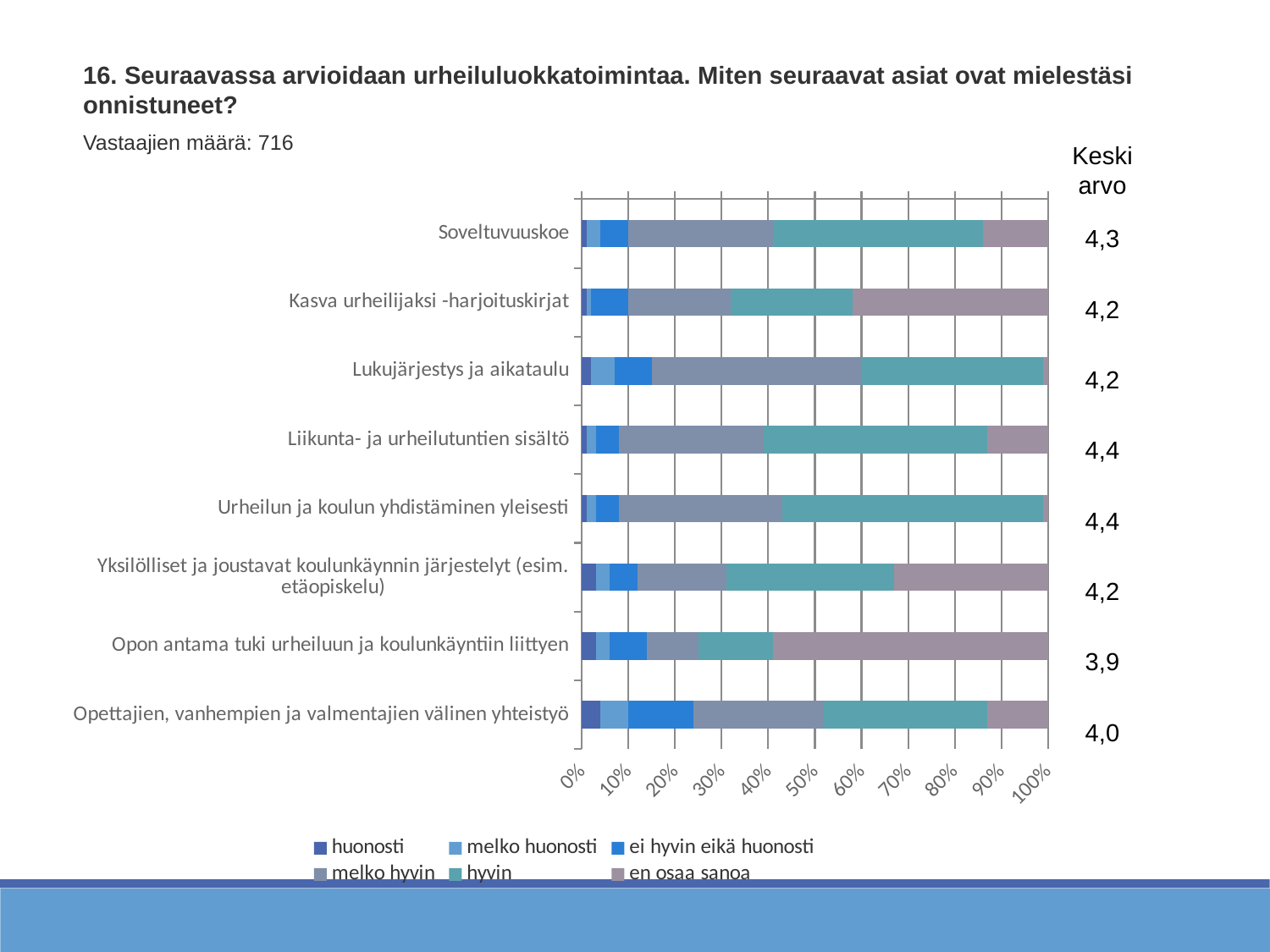
How many categories (rows) does the chart show? 8 Is the 'en osaa sanoa' share for Opon antama tuki urheiluun ja koulunkäyntiin liittyen greater or less than 50%? greater Which category has the lowest keskiarvo? Opon antama tuki urheiluun ja koulunkäyntiin liittyen Is the 'melko hyvin' share for Soveltuvuuskoe greater or less than 20%? greater What is the keskiarvo (mean) shown for Soveltuvuuskoe? 4,3 How many series does the legend list? 6 What is the keskiarvo shown for Opettajien, vanhempien ja valmentajien välinen yhteistyö? 4,0 What kind of chart is shown on the slide? bar chart Which has the larger 'en osaa sanoa' share: Opon antama tuki urheiluun ja koulunkäyntiin liittyen or Soveltuvuuskoe? Opon antama tuki urheiluun ja koulunkäyntiin liittyen What is the keskiarvo shown for Opon antama tuki urheiluun ja koulunkäyntiin liittyen? 3,9 How many respondents (Vastaajien määrä) are reported on the slide? 716 What is the difference between the keskiarvo of Soveltuvuuskoe and that of Opon antama tuki urheiluun ja koulunkäyntiin liittyen? 0,4